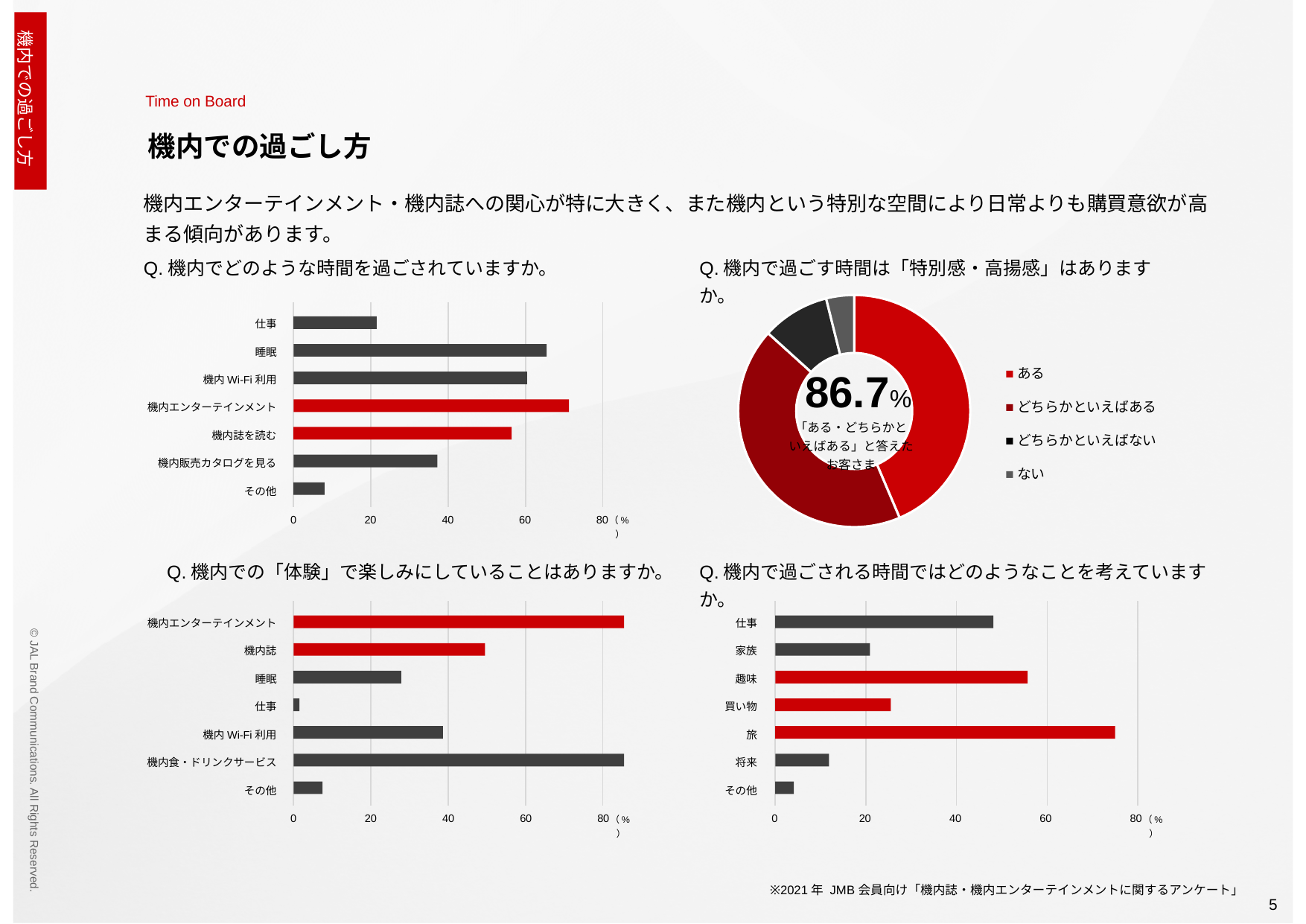
In the top-left chart 'Q. 機内でどのような時間を過ごされていますか。', which category has the lowest value? その他 How many entries does the legend of the top-right donut chart list? 4 In the top-left chart 'Q. 機内でどのような時間を過ごされていますか。', how many categories are plotted? 7 In the bottom-left chart 'Q. 機内での「体験」で楽しみにしていることはありますか。', is the value for 機内誌 greater or less than 40? greater In the bottom-left chart 'Q. 機内での「体験」で楽しみにしていることはありますか。', which category has the lowest value? 仕事 In the top-left chart 'Q. 機内でどのような時間を過ごされていますか。', is the value for 睡眠 greater or less than 60? greater In the top-left chart 'Q. 機内でどのような時間を過ごされていますか。', which category has the highest value? 機内エンターテインメント In the bottom-right chart 'Q. 機内で過ごされる時間ではどのようなことを考えていますか。', which is larger, the value for 趣味 or the value for 家族? 趣味 What percentage is printed in the centre of the top-right donut chart? 86.7% What kind of chart is used for 'Q. 機内でどのような時間を過ごされていますか。' (top-left)? bar chart What kind of chart is used for 'Q. 機内で過ごす時間は「特別感・高揚感」はありますか。' (top-right)? donut chart In the bottom-right chart 'Q. 機内で過ごされる時間ではどのようなことを考えていますか。', which category has the highest value? 旅